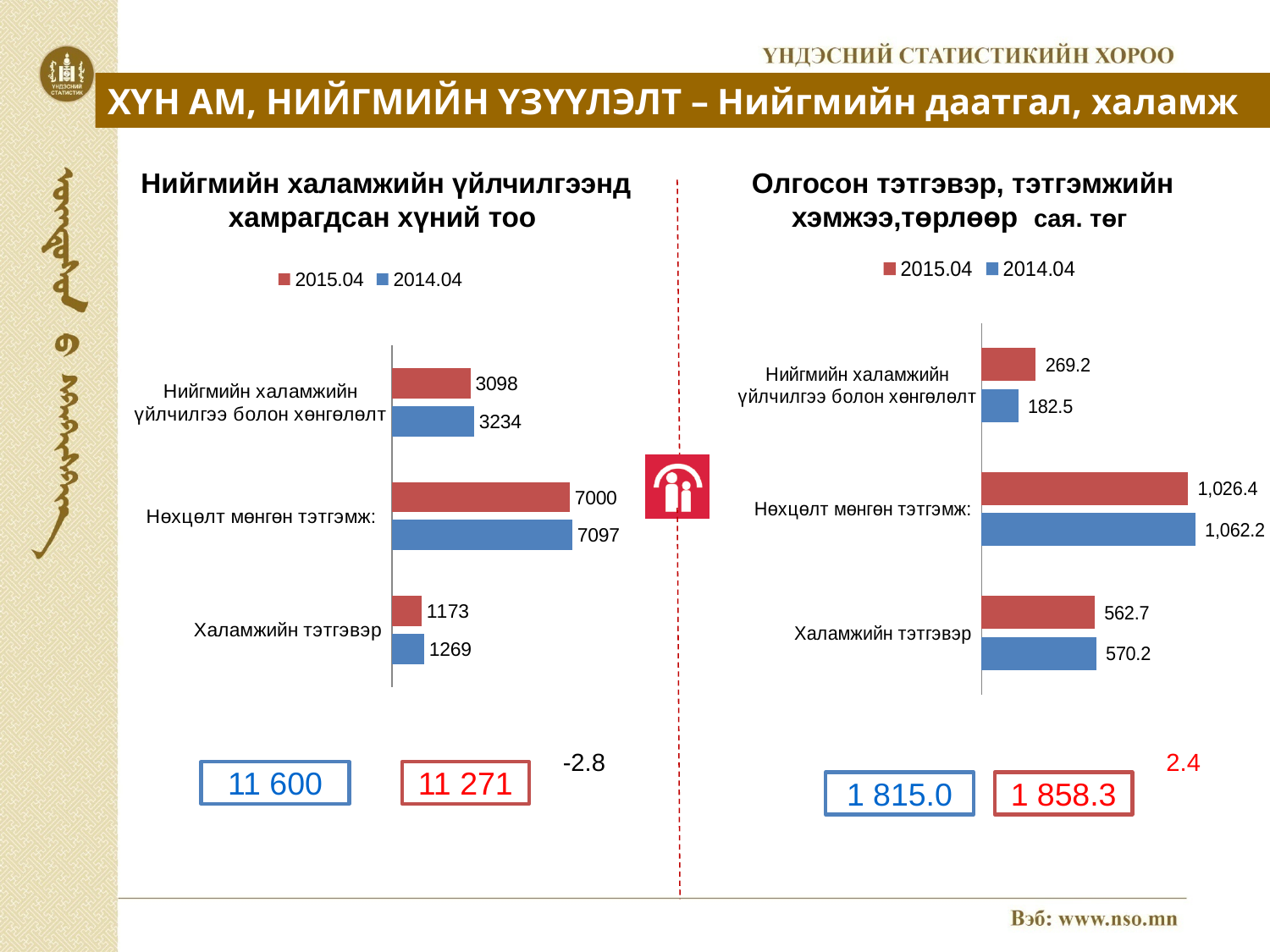
In the right chart (Олгосон тэтгэвэр, тэтгэмжийн хэмжээ, төрлөөр сая. төг), what is the 2015.04 value for Нийгмийн халамжийн үйлчилгээ болон хөнгөлөлт? 269.2 In the left chart (Нийгмийн халамжийн үйлчилгээнд хамрагдсан хүний тоо), what is the 2014.04 value for Халамжийн тэтгэвэр? 1269 In the right chart (Олгосон тэтгэвэр, тэтгэмжийн хэмжээ, төрлөөр сая. төг), what is the 2014.04 value for Нөхцөлт мөнгөн тэтгэмж? 1,062.2 In the right chart (Олгосон тэтгэвэр, тэтгэмжийн хэмжээ, төрлөөр сая. төг), how many categories are shown? 3 In the left chart (Нийгмийн халамжийн үйлчилгээнд хамрагдсан хүний тоо), what is the difference between the 2014.04 and 2015.04 values for Нийгмийн халамжийн үйлчилгээ болон хөнгөлөлт? 136 In the right chart (Олгосон тэтгэвэр, тэтгэмжийн хэмжээ, төрлөөр сая. төг), which is larger for Халамжийн тэтгэвэр: the 2015.04 value or the 2014.04 value? 2014.04 What type of chart is the right chart (Олгосон тэтгэвэр, тэтгэмжийн хэмжээ, төрлөөр сая. төг)? Bar chart In the left chart (Нийгмийн халамжийн үйлчилгээнд хамрагдсан хүний тоо), what is the 2015.04 value for Нөхцөлт мөнгөн тэтгэмж? 7000 In the left chart (Нийгмийн халамжийн үйлчилгээнд хамрагдсан хүний тоо), which category has the lowest 2014.04 value? Халамжийн тэтгэвэр In the right chart (Олгосон тэтгэвэр, тэтгэмжийн хэмжээ, төрлөөр сая. төг), what is the difference between the 2015.04 and 2014.04 values for Нийгмийн халамжийн үйлчилгээ болон хөнгөлөлт? 86.7 In the left chart (Нийгмийн халамжийн үйлчилгээнд хамрагдсан хүний тоо), how many series does the legend list? 2 In the left chart (Нийгмийн халамжийн үйлчилгээнд хамрагдсан хүний тоо), which category has the highest 2015.04 value? Нөхцөлт мөнгөн тэтгэмж